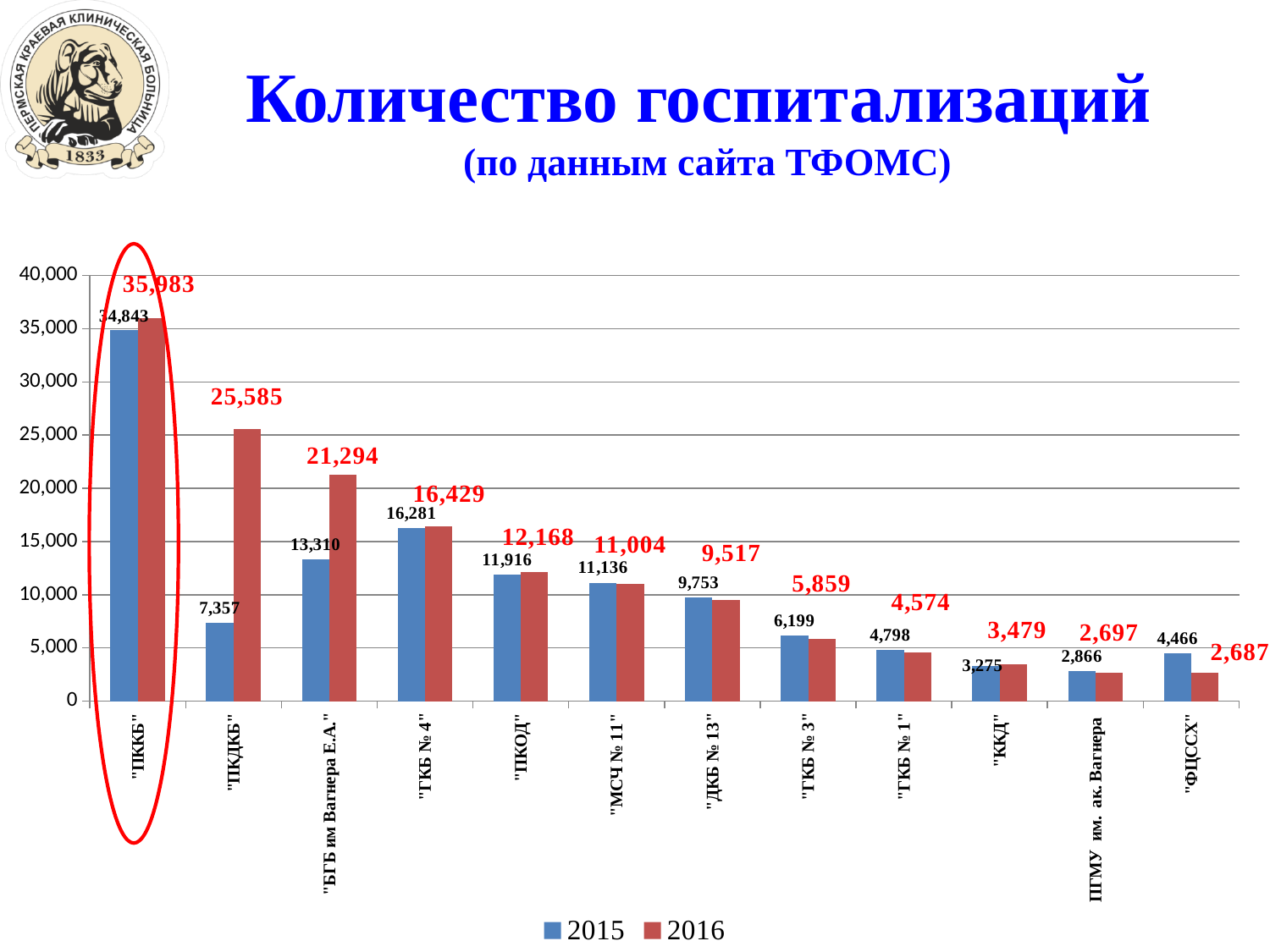
Which hospital has the highest 2016 value? "ПККБ" For "ГКБ № 3", which year has the larger value, 2015 or 2016? 2015 How many series does the legend list? 2 What kind of chart is shown on the slide? bar chart What is the difference between the 2016 and 2015 values for "ПКДКБ"? 18,228 What is the 2016 value for "ПКДКБ"? 25,585 Is the 2016 value for "БГБ им Вагнера Е.А." greater or less than 20,000? greater How many hospitals (categories) are shown on the x axis? 12 Which hospital has the lowest 2015 value? ПГМУ им. ак. Вагнера What is the 2015 value for "ФЦССХ"? 4,466 What is the 2015 value for "ГКБ № 4"? 16,281 What are the two entries in the legend? 2015 and 2016